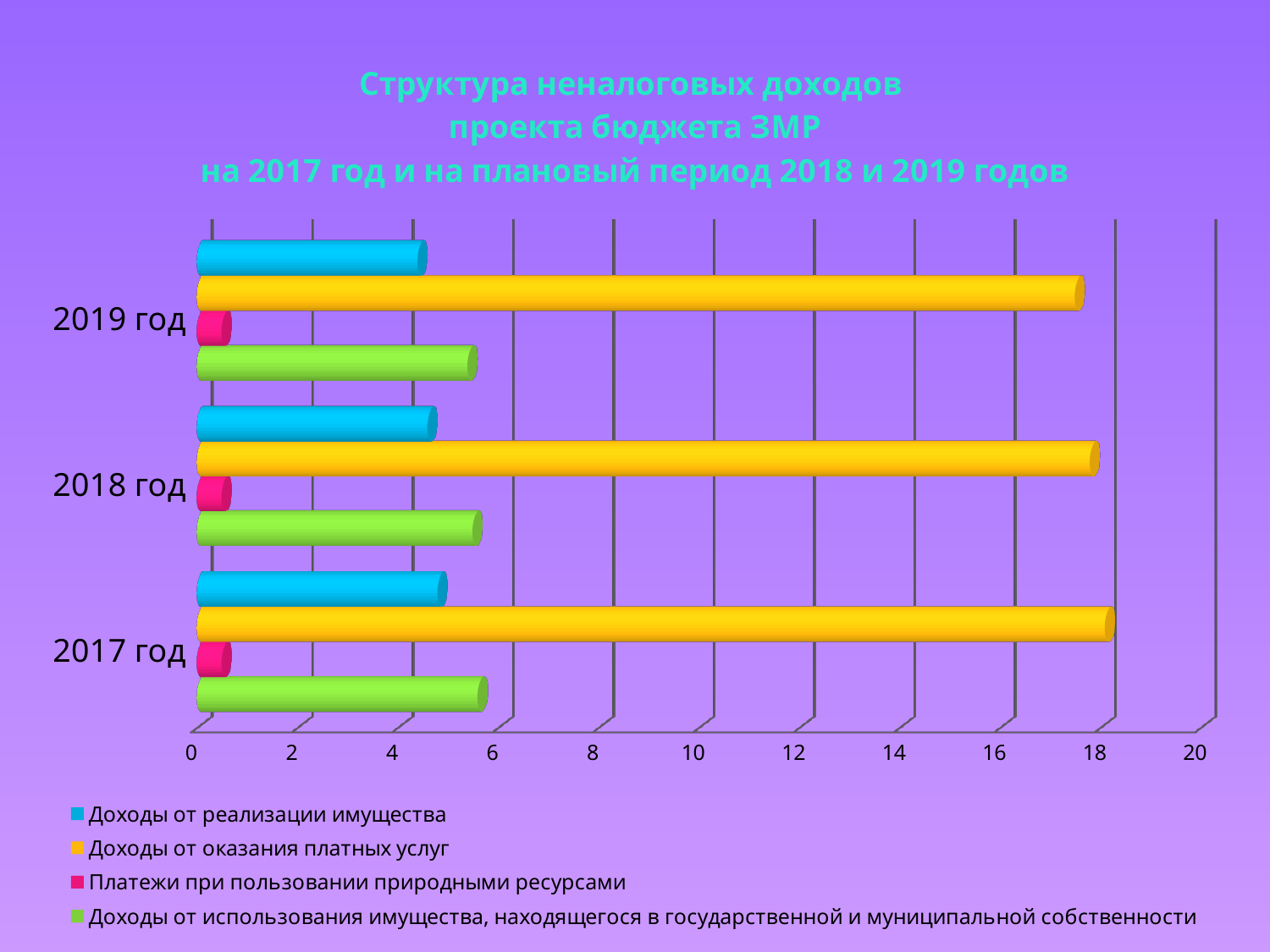
Is the value for Доходы от использования имущества, находящегося в государственной и муниципальной собственности in 2018 год greater or less than 4? greater What colour represents Платежи при пользовании природными ресурсами in the chart? Pink How many series does the legend list? 4 Is the value for Платежи при пользовании природными ресурсами in 2018 год greater or less than 2? less Is the value for Доходы от реализации имущества in 2019 год greater or less than 6? less What kind of chart is shown on the slide? Bar chart In 2018 год, which is larger: Доходы от оказания платных услуг or Доходы от реализации имущества? Доходы от оказания платных услуг In 2019 год, which is larger: Доходы от использования имущества, находящегося в государственной и муниципальной собственности or Доходы от реализации имущества? Доходы от использования имущества, находящегося в государственной и муниципальной собственности How many year categories are shown on the chart? 3 Which series has the longest bar for 2017 год? Доходы от оказания платных услуг Which series has the shortest bar for 2019 год? Платежи при пользовании природными ресурсами